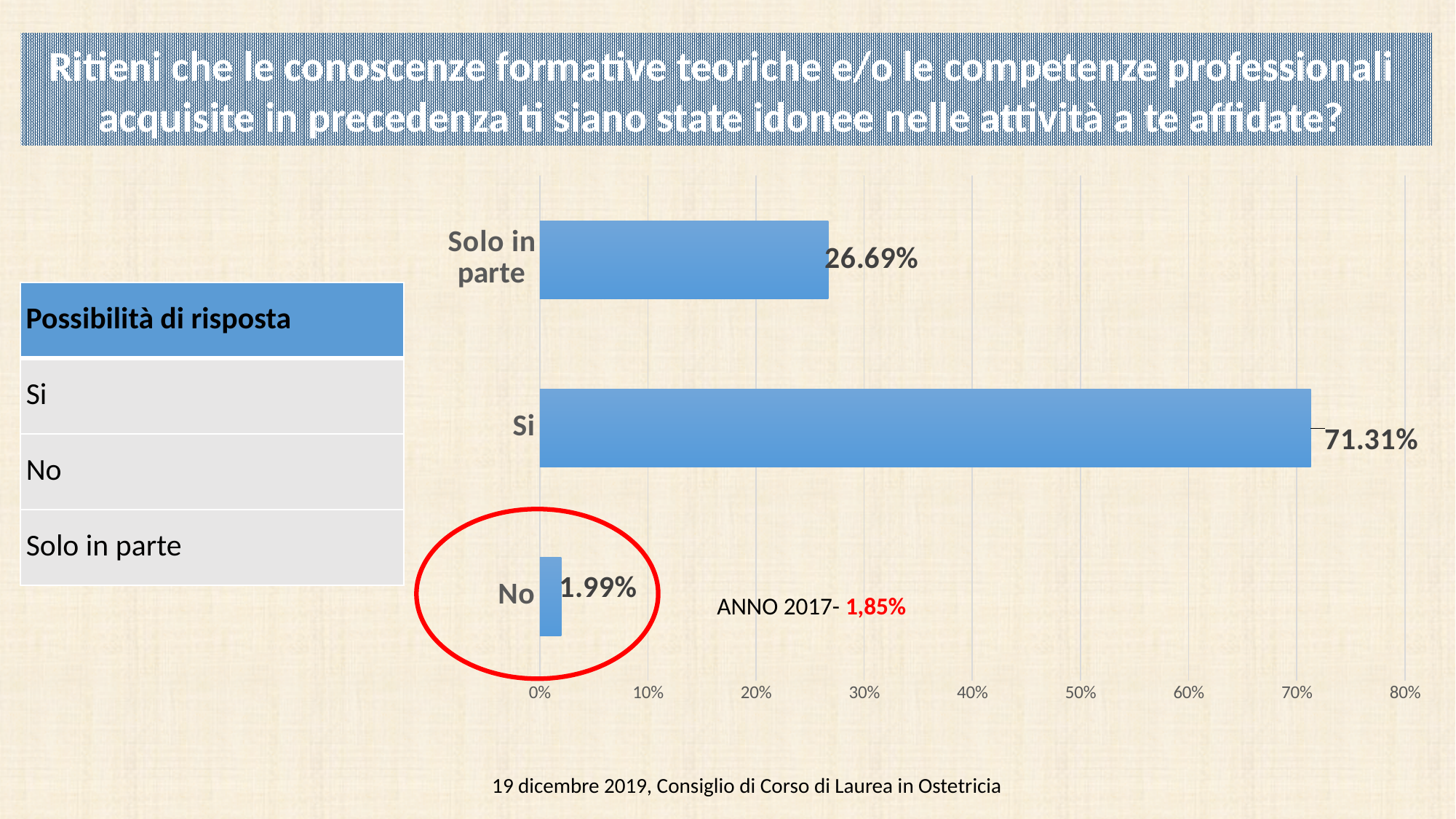
What kind of chart is shown on the slide? bar chart Which category has the lowest value? No What is the difference between the values for "Si" and "Solo in parte"? 44.62% Which is larger, the value for "Solo in parte" or the value for "No"? Solo in parte What is the difference between the values for "Solo in parte" and "No"? 24.70% Which category has the highest value? Si What is the value for "Si"? 71.31% What is the value for "No"? 1.99% Is the value for "Si" greater or less than 70%? greater How many categories are shown in the chart? 3 What is the value for "Solo in parte"? 26.69% Which category on the chart is circled in red? No